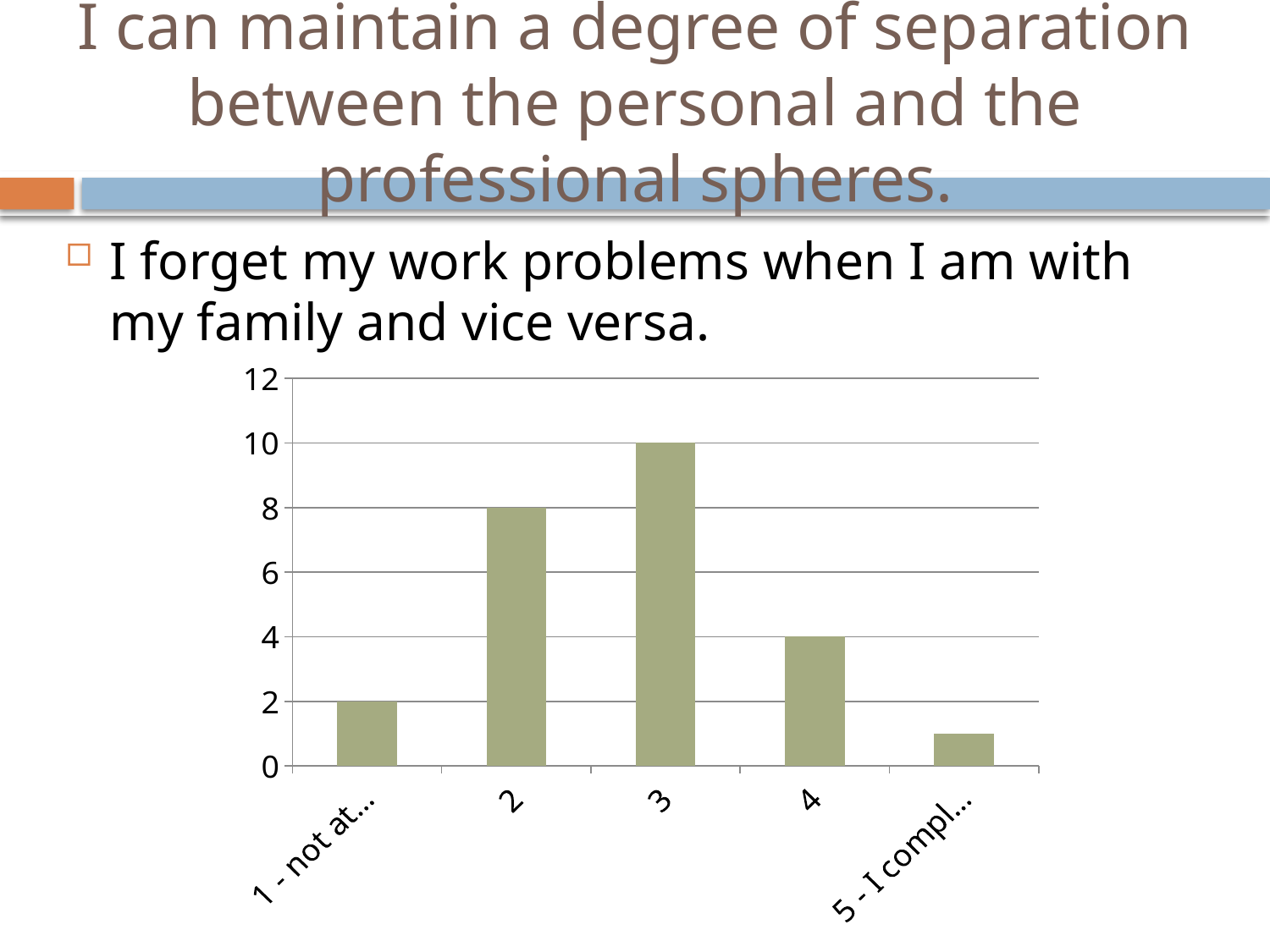
What is the difference between the values for category 2 and category 4? 4 Is the value for the last category, "5 - I compl...", greater or less than 2? less What is the value of the bar for the first category, "1 - not at..."? 2 Which category has the highest bar? 3 Which category has the lowest bar? 5 - I compl... Which has a larger value, category 2 or category 4? 2 How many categories are shown on the x axis? 5 What is the value of the bar for category 4? 4 What is the value of the bar for category 3? 10 What is the difference between the values for category 3 and category 2? 2 What kind of chart is shown on the slide? bar chart What is the value of the bar for category 2? 8